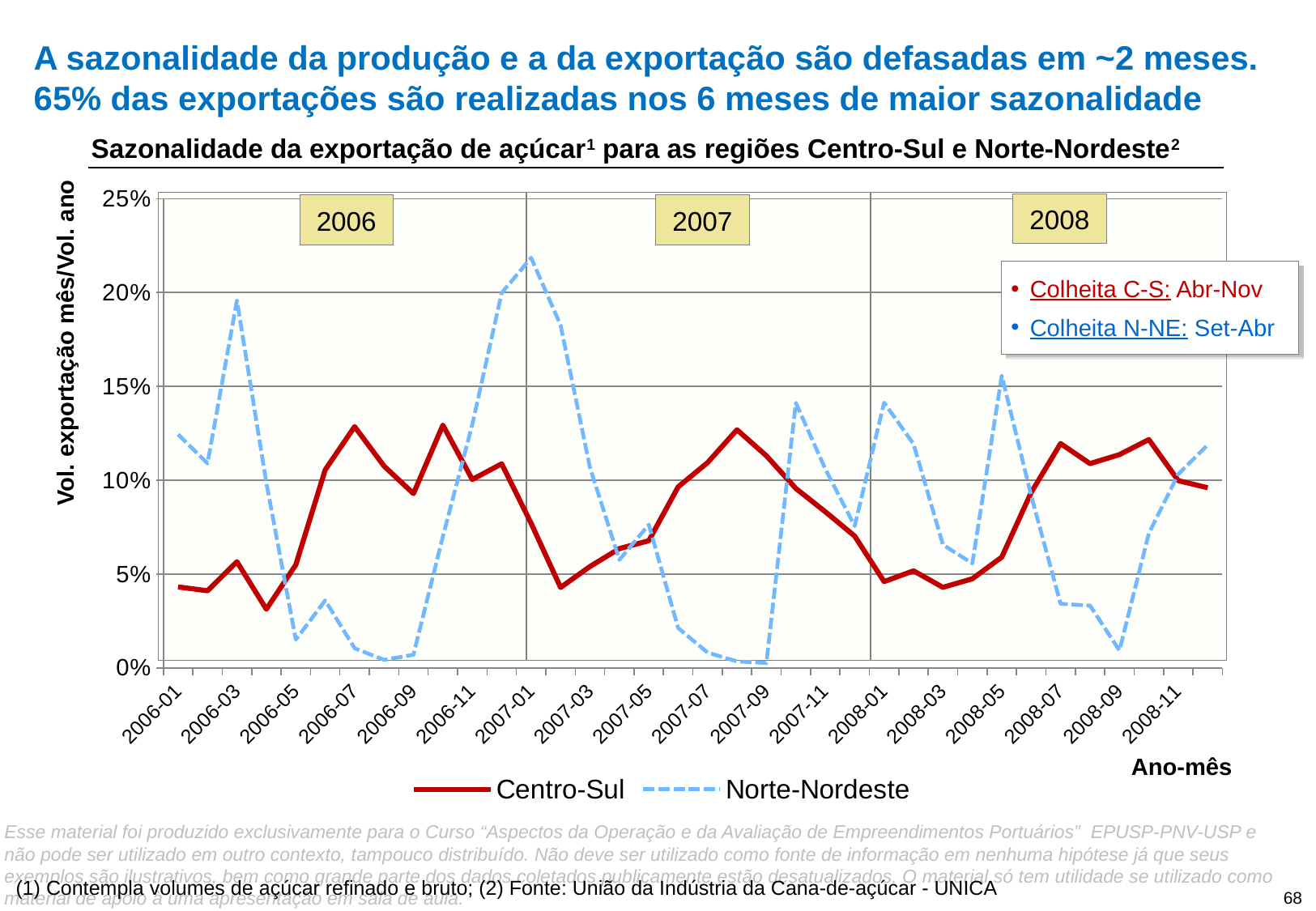
Does the Norte-Nordeste series rise or fall between 2007-01 and 2007-07? Fall What kind of chart is shown on the slide? Line chart Is the Norte-Nordeste value at 2006-03 greater or less than 15%? greater Is the Norte-Nordeste value at 2007-09 greater or less than 5%? less Which two series are listed in the chart legend? Centro-Sul and Norte-Nordeste At 2006-07, which series has the higher value, Centro-Sul or Norte-Nordeste? Centro-Sul Is the Centro-Sul value at 2006-01 greater or less than 5%? less How many years are marked by the labelled boxes inside the chart? 3 How many series does the chart legend list? 2 At which month does the Norte-Nordeste series reach its highest value? 2007-01 At 2007-01, which series has the higher value, Centro-Sul or Norte-Nordeste? Norte-Nordeste